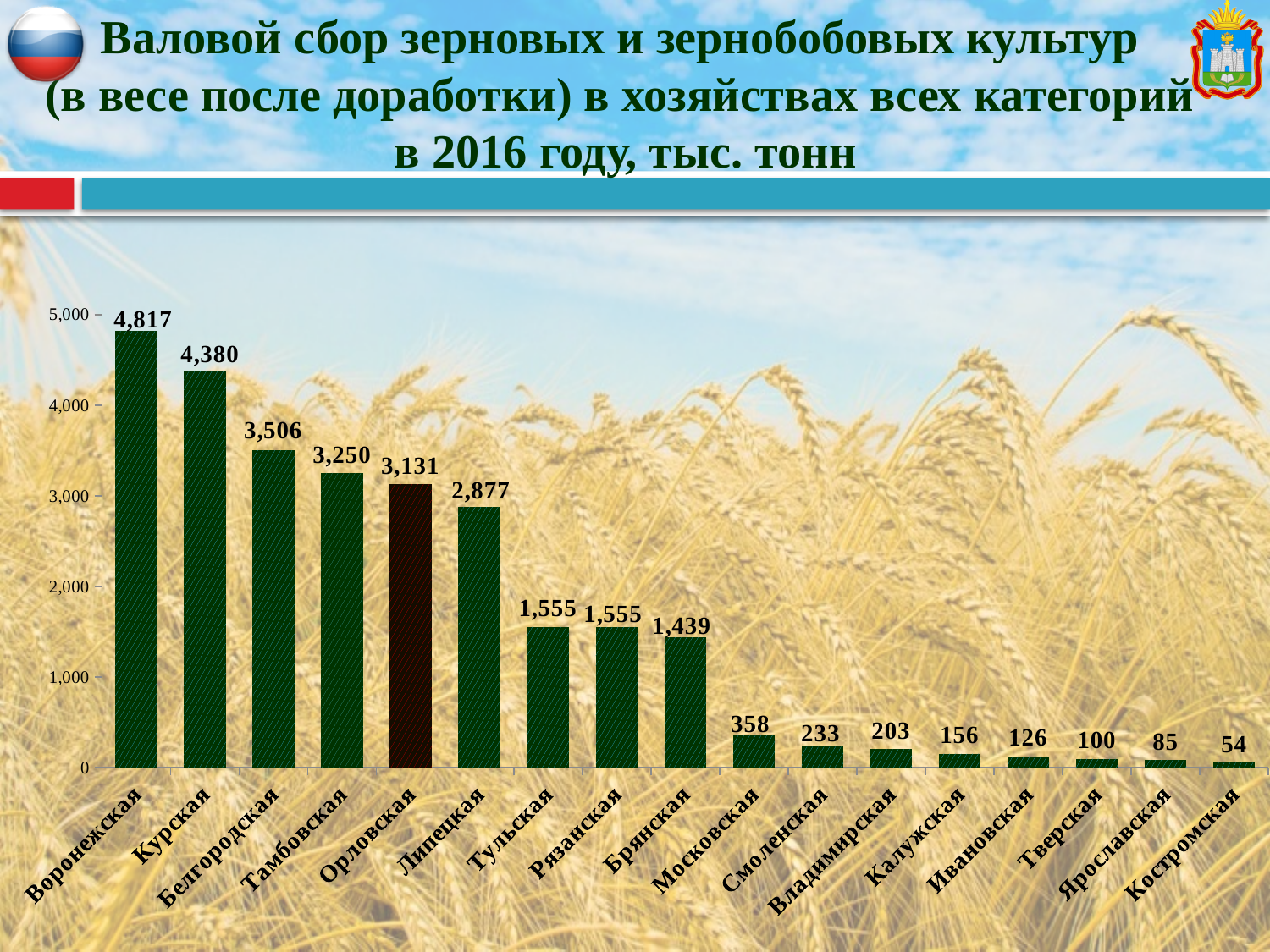
What is the difference between the values for Воронежская and Курская? 437 What is the value for Московская? 358 Do the values rise or fall from left to right along the x axis? fall What is the value for Орловская? 3,131 How many regions are shown in the chart? 17 Which region has the highest value? Воронежская Which is larger, the value for Липецкая or the value for Брянская? Липецкая What kind of chart is shown on the slide? bar chart Is the value for Курская greater or less than 4,000? greater What is the difference between the values for Белгородская and Тамбовская? 256 Which region has the lowest value? Костромская What is the value for Воронежская? 4,817